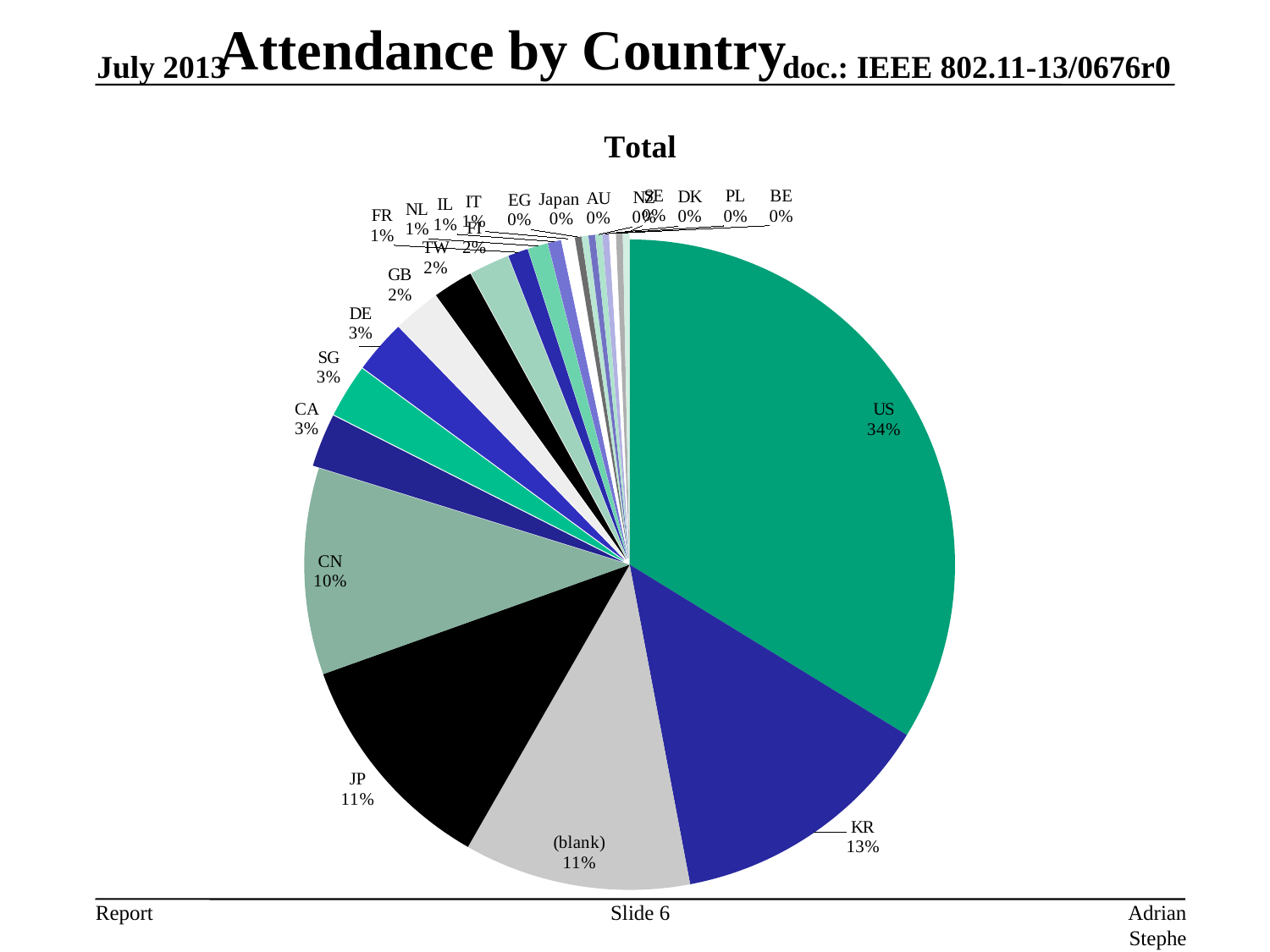
What percentage is shown for JP? 11% Which country has the largest share of attendance? US How many percentage points larger is the US share than the KR share? 21 What kind of chart is shown on the slide? Pie chart What percentage is shown for KR? 13% What share is shown for CN? 10% Which has a larger share, KR or CN? KR What percentage is shown for GB? 2% What share of attendance does US have in the pie chart? 34% What share is shown for the (blank) slice? 11% What is the title of the chart? Total What percentage is shown for CA? 3%